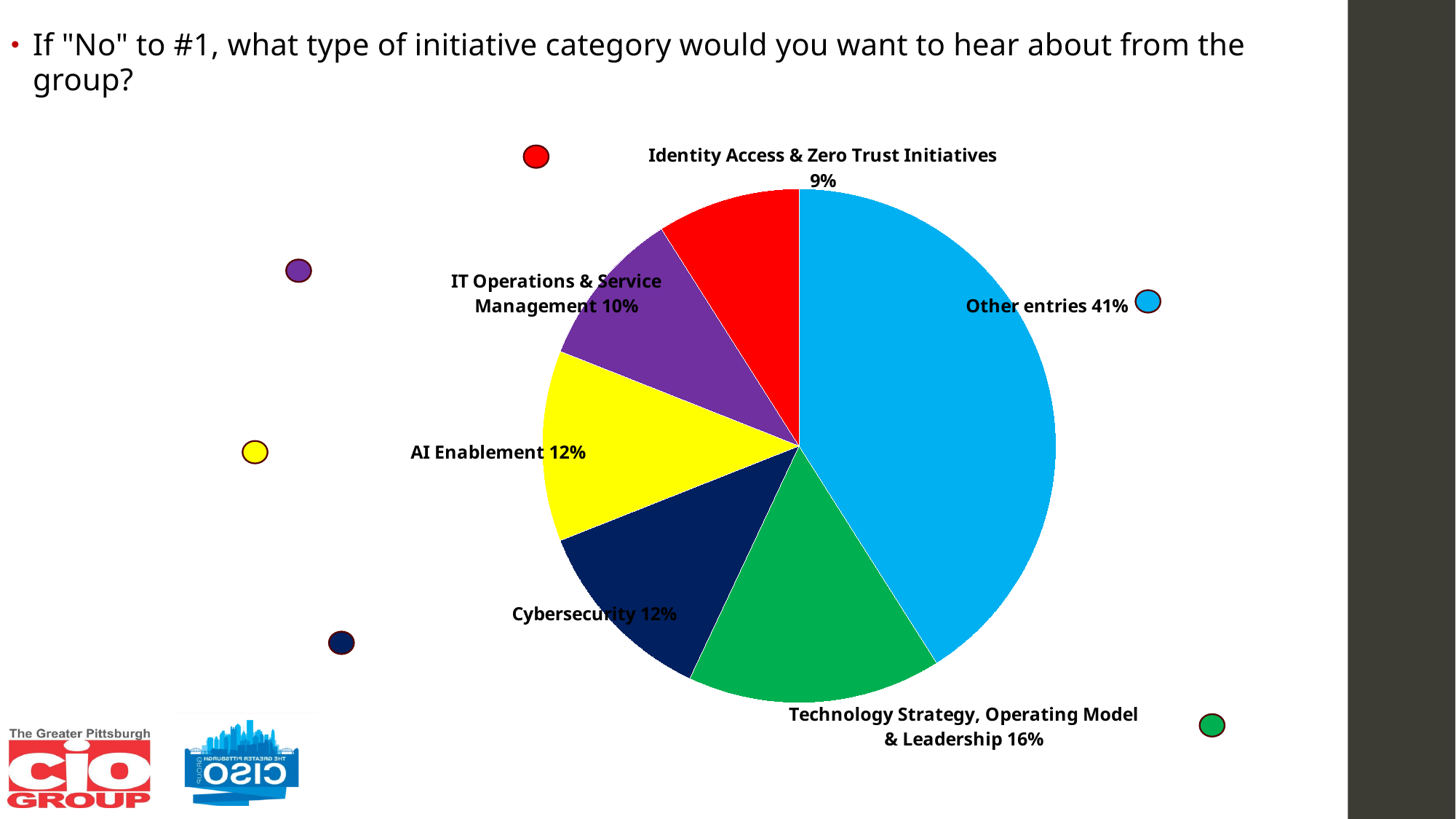
What percentage is shown for AI Enablement? 12% What percentage is shown for Identity Access & Zero Trust Initiatives? 9% Which category has the largest slice of the pie? Other entries What is the difference in percentage points between Other entries and Technology Strategy, Operating Model & Leadership? 25 What kind of chart is shown on the slide? pie chart Which category has the smallest slice of the pie? Identity Access & Zero Trust Initiatives What colour is the slice for AI Enablement? yellow How many slices does the pie chart have? 6 What percentage is shown for IT Operations & Service Management? 10% Which is larger, the share for Cybersecurity or the share for IT Operations & Service Management? Cybersecurity What share of the pie is labelled "Other entries"? 41% What percentage is shown for Technology Strategy, Operating Model & Leadership? 16%